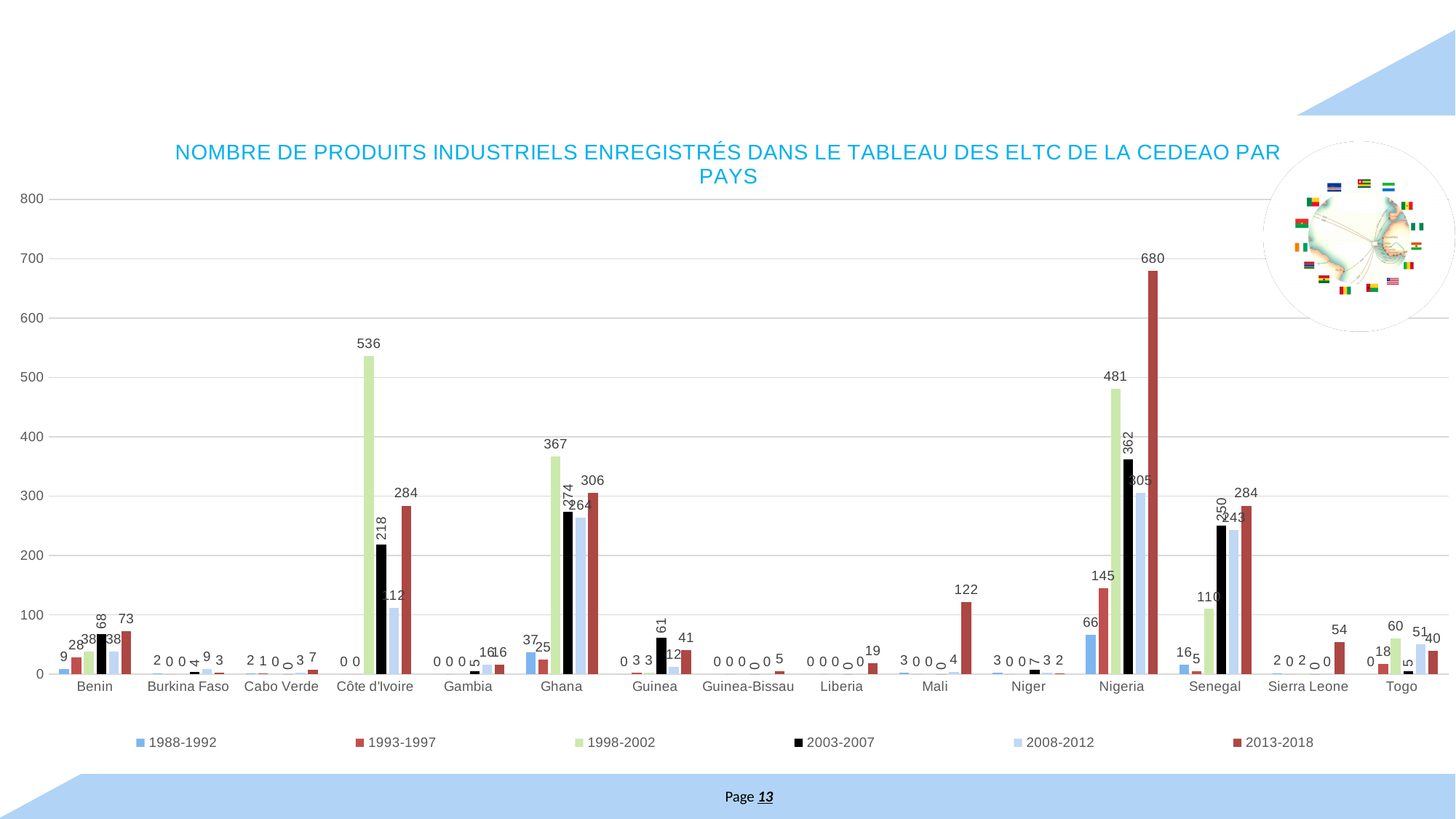
What is the title of the chart? NOMBRE DE PRODUITS INDUSTRIELS ENREGISTRÉS DANS LE TABLEAU DES ELTC DE LA CEDEAO PAR PAYS Which country has the highest value in the 2013-2018 series? Nigeria How many series does the legend list? 6 What is the value for Mali in the 2013-2018 series? 122 What type of chart is shown on the slide? bar chart Which is larger: Senegal's 2013-2018 value or Ghana's 2013-2018 value? Ghana's 2013-2018 value What is the value for Nigeria in the 2013-2018 series? 680 What is the difference between Nigeria's 2013-2018 value and its 1998-2002 value? 199 Which country has the highest value in the 1998-2002 series? Côte d'Ivoire What is the value for Côte d'Ivoire in the 1998-2002 series? 536 How many countries are shown on the x axis? 15 What is the value for Ghana in the 2003-2007 series? 274